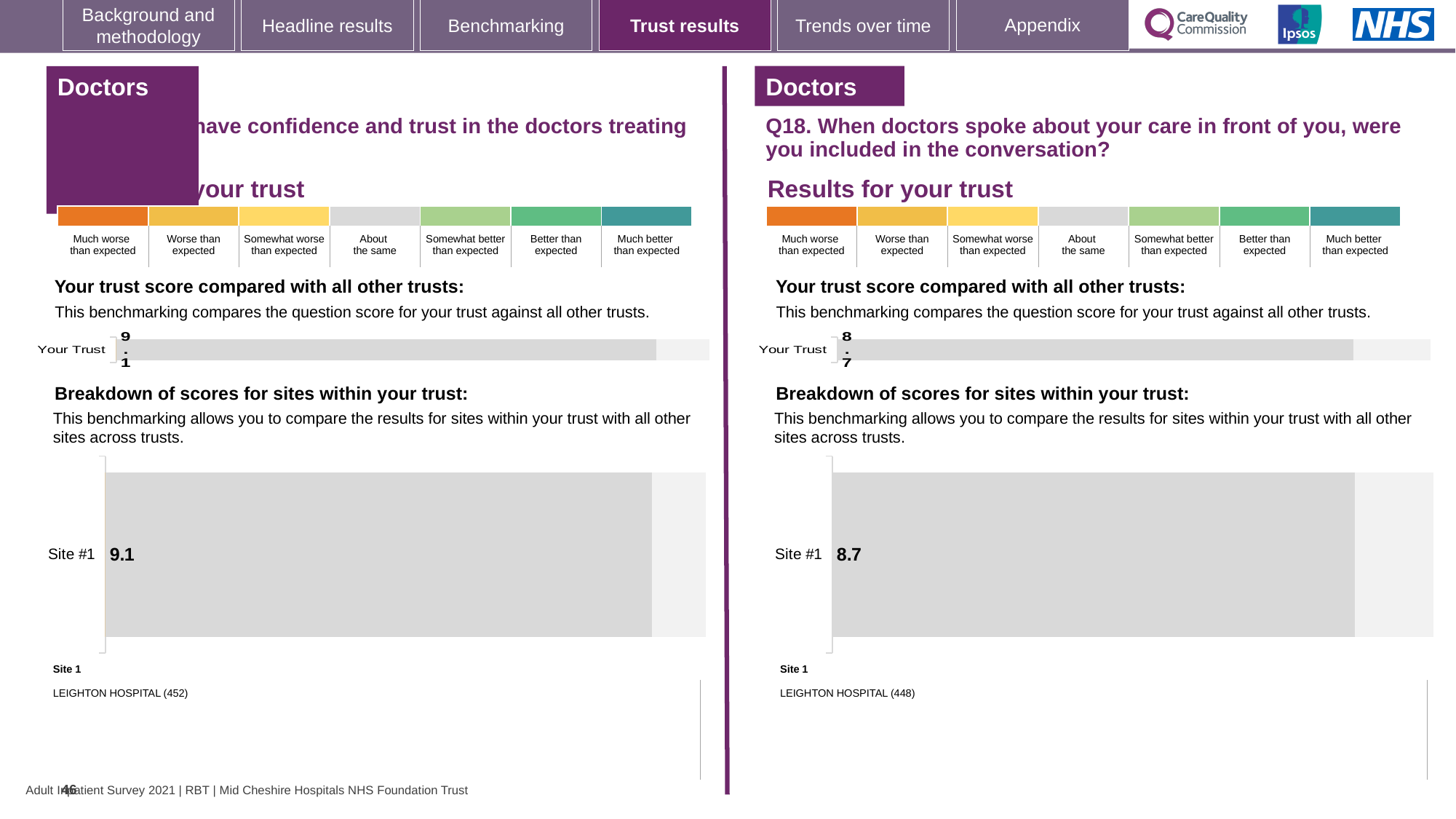
In the right (Q18) 'Breakdown of scores for sites within your trust' chart, what is the score for Site #1? 8.7 In the left 'Breakdown of scores for sites within your trust' chart, what is the score for Site #1? 9.1 What type of chart is used to show the Site #1 score on the right (Q18) half of the slide? Bar chart On the right half of the slide (Q18), what is the score shown for Your Trust in the 'Your trust score compared with all other trusts' chart? 8.7 On the left half of the slide, what is the score shown for Your Trust in the 'Your trust score compared with all other trusts' chart? 9.1 Which hospital is listed as Site 1 under the right (Q18) site breakdown chart? LEIGHTON HOSPITAL (448) What is the difference between the Site #1 score on the left chart and the Site #1 score on the right (Q18) chart? 0.4 How many bars are plotted in the left 'Your trust score compared with all other trusts' chart? 1 Which hospital is listed as Site 1 under the left site breakdown chart? LEIGHTON HOSPITAL (452) Which is larger: the Your Trust score on the left half of the slide or the Your Trust score on the right half (Q18)? Left (9.1) How many sites are shown in the right (Q18) 'Breakdown of scores for sites within your trust' chart? 1